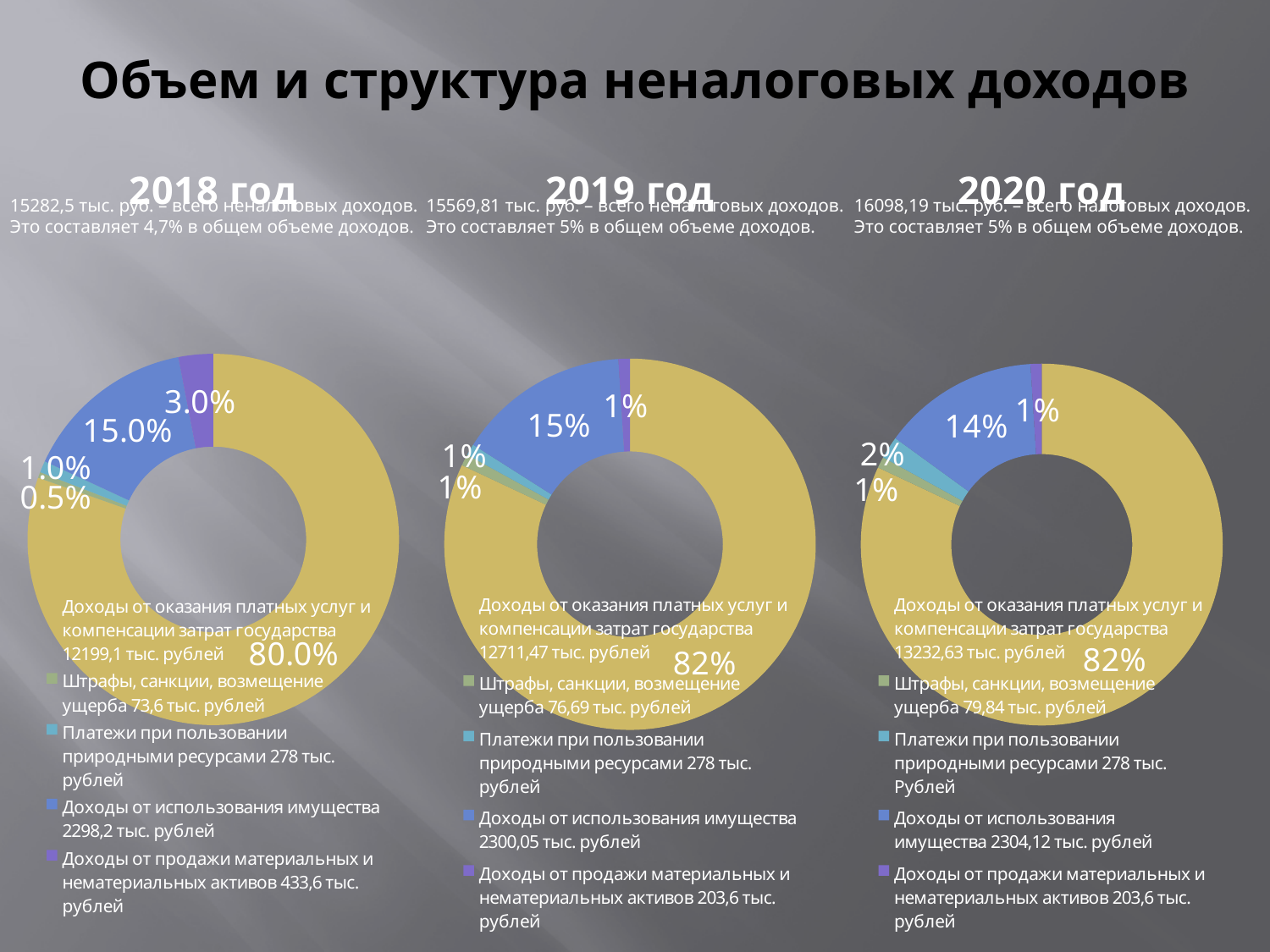
In the 2019 год chart, what share is shown for Доходы от оказания платных услуг и компенсации затрат государства? 82% What kind of chart is used for the 2018 год data? doughnut chart How many categories are shown in the 2018 год chart? 5 In the 2018 год chart, what is the difference in percentage points between the share for Доходы от оказания платных услуг и компенсации затрат государства and the share for Доходы от использования имущества? 65.0 In the 2018 год chart, what share is shown for Доходы от продажи материальных и нематериальных активов? 3.0% In the 2020 год chart, which is larger: the share for Платежи при пользовании природными ресурсами or the share for Штрафы, санкции, возмещение ущерба? Платежи при пользовании природными ресурсами In the 2018 год chart, which category has the largest share? Доходы от оказания платных услуг и компенсации затрат государства In the 2020 год chart, what share is shown for Платежи при пользовании природными ресурсами? 2% In the 2018 год chart, which category has the smallest share? Штрафы, санкции, возмещение ущерба In the 2018 год chart, what share is shown for Доходы от использования имущества? 15.0% In the 2019 год chart, what share is shown for Доходы от использования имущества? 15% In the 2019 год chart legend, what amount is given for Доходы от оказания платных услуг и компенсации затрат государства? 12711,47 тыс. рублей